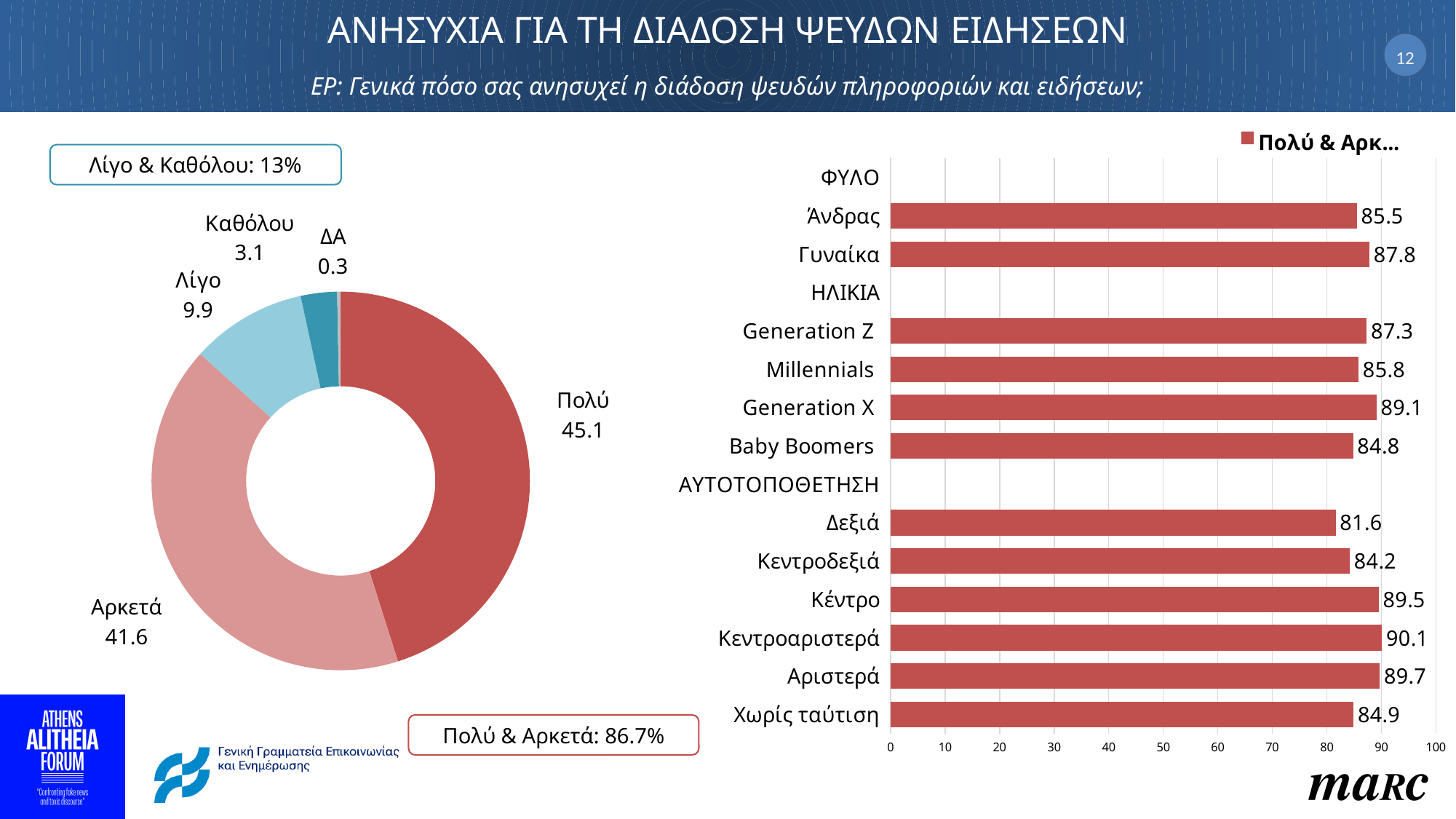
What kind of chart is shown on the right side of the slide? Bar chart In the bar chart on the right, which is larger, Millennials or Baby Boomers? Millennials In the bar chart on the right, what is the value for Generation X? 89.1 In the bar chart on the right, which category has the highest value? Κεντροαριστερά In the bar chart on the right, which category has the lowest value? Δεξιά In the donut chart on the left, which category has the smallest value? ΔΑ In the donut chart on the left, what is the value for Πολύ? 45.1 In the donut chart on the left, how many categories are shown? 5 In the donut chart on the left, what is the difference between Λίγο and Καθόλου? 6.8 In the bar chart on the right, what is the difference between Γυναίκα and Άνδρας? 2.3 In the donut chart on the left, what is the value for Αρκετά? 41.6 In the bar chart on the right, what is the value for Χωρίς ταύτιση? 84.9